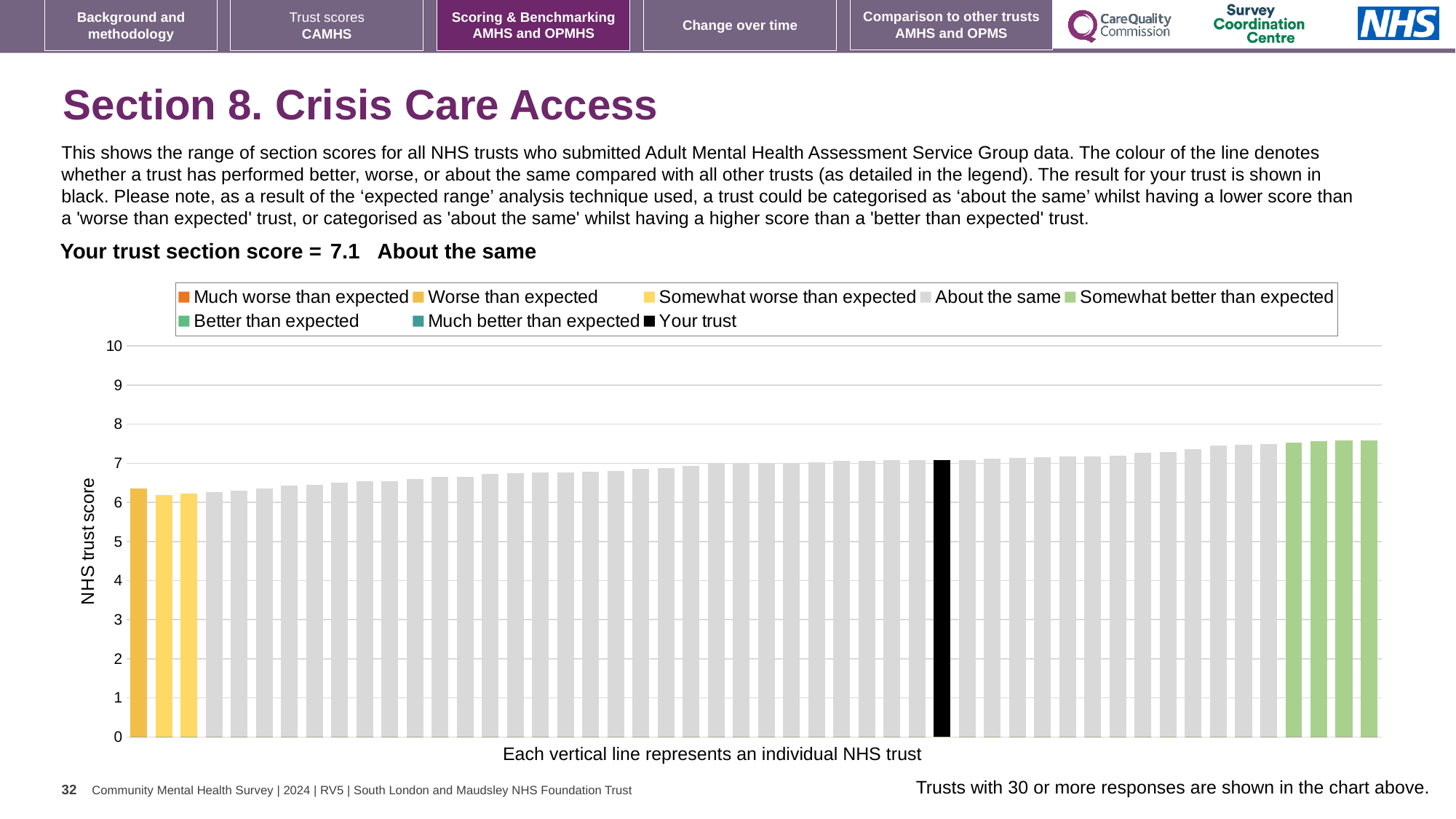
Is the value for your trust (the black bar) greater or less than 6? greater Is the value for the leftmost bar greater or less than 7? less What is the label on the vertical axis of the chart? NHS trust score How many bars are coloured green (somewhat better than expected)? 4 What kind of chart is shown on the slide? bar chart How many entries does the chart legend list? 8 What is your trust's section score for Crisis Care Access? 7.1 Is the value for the tallest bar greater or less than 8? less What colour is used for the 'Your trust' bar in the chart? black Which category is your trust placed in for this section? About the same Do the bar values rise or fall from left to right across the chart? rise Is the black bar for your trust higher or lower than the leftmost bar? higher